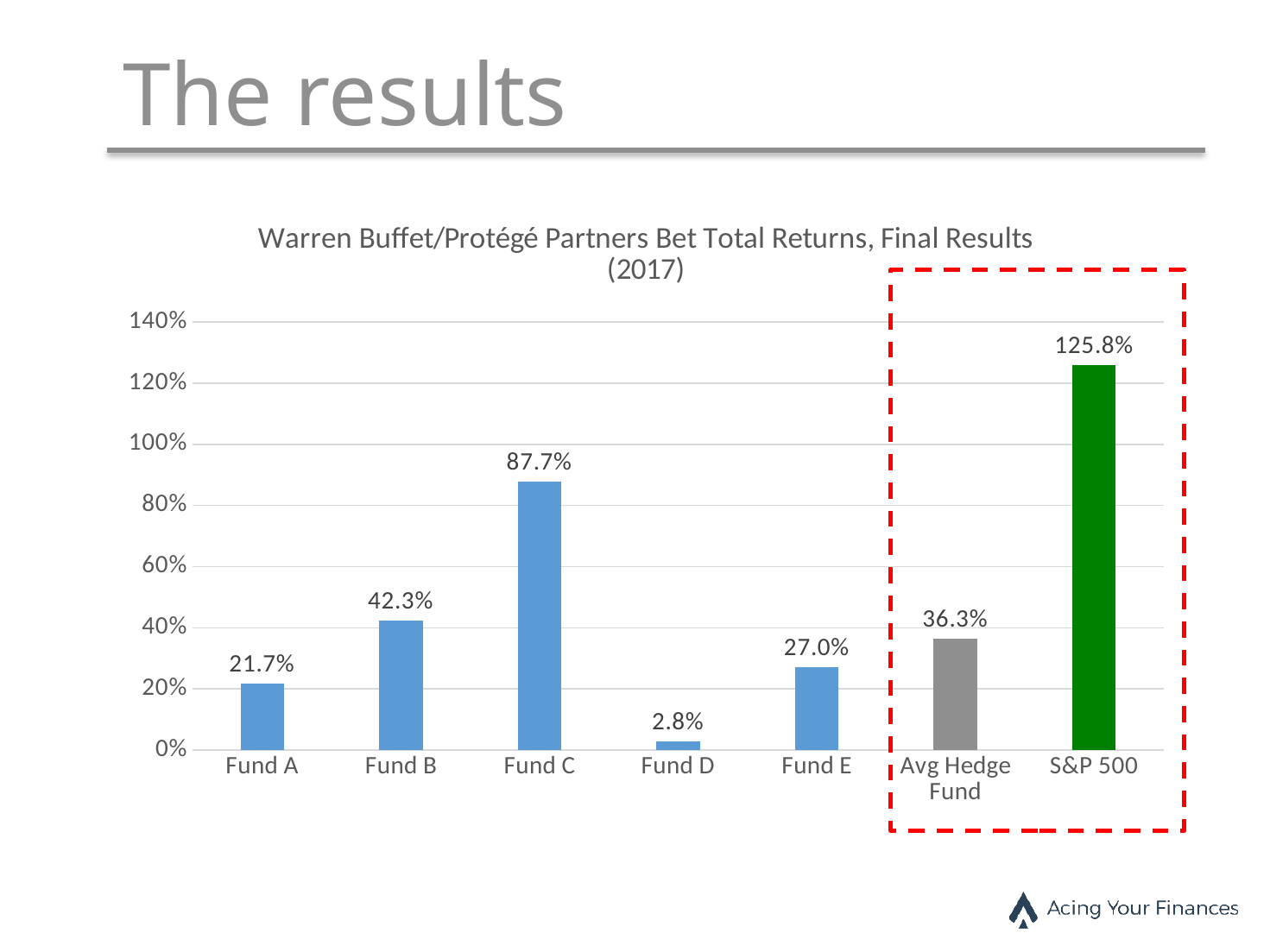
What is the total return for Fund C? 87.7% Which has a higher total return, Fund E or Fund B? Fund B Which category has the highest total return? S&P 500 What is the total return for the S&P 500? 125.8% What kind of chart is shown on the slide? Bar chart What colour is the S&P 500 bar? Green What is the total return for the Avg Hedge Fund? 36.3% What is the difference between Fund B and Fund A returns? 20.6% What is the difference between the S&P 500 return and the Avg Hedge Fund return? 89.5% Which category has the lowest total return? Fund D Is the value for Fund C greater or less than 100%? less How many categories are shown on the x axis? 7